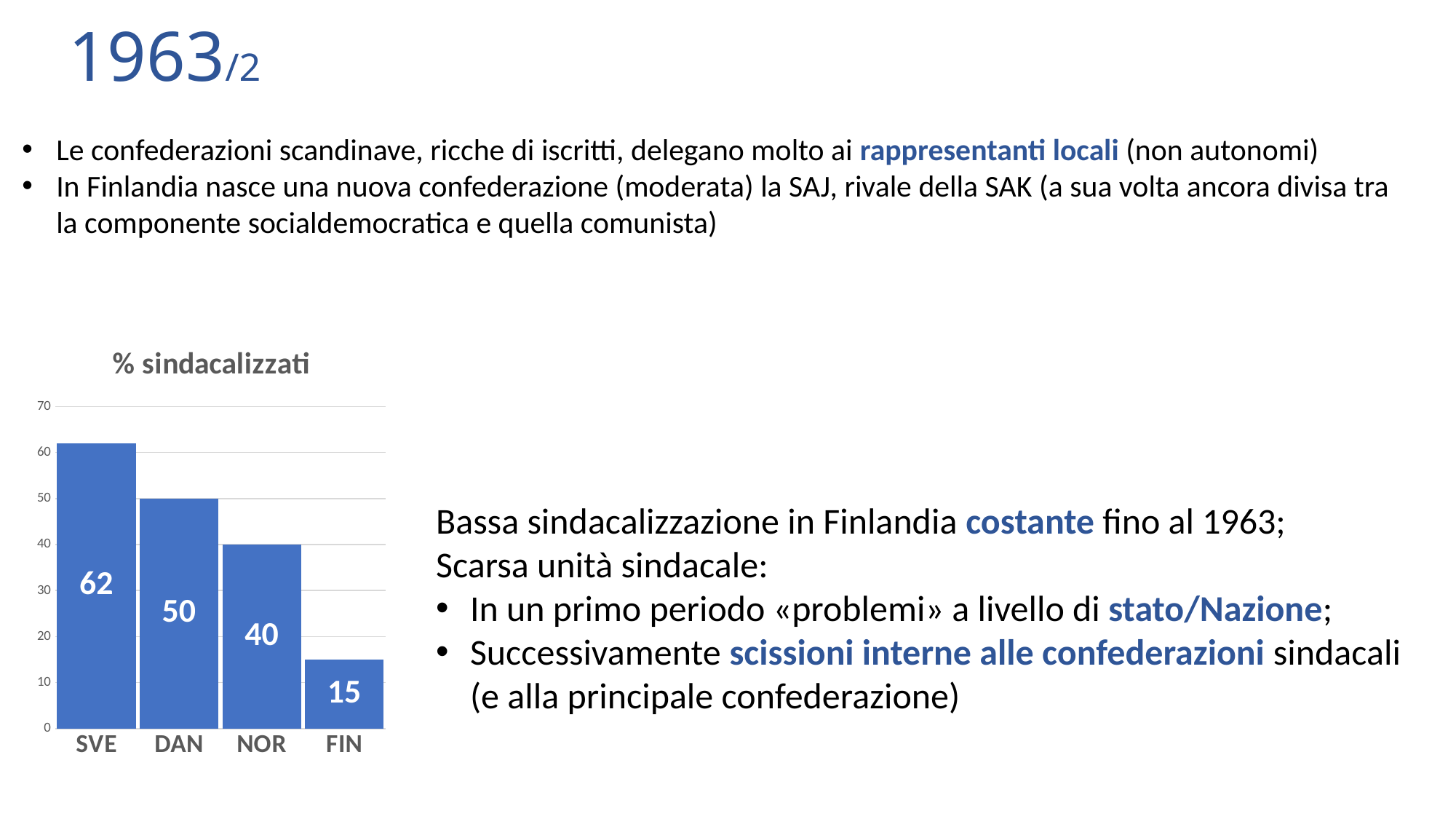
What is the value for SVE in the '% sindacalizzati' chart? 62 What is the difference between the values for SVE and FIN in the '% sindacalizzati' chart? 47 What is the value for FIN in the '% sindacalizzati' chart? 15 What is the difference between the values for DAN and NOR in the '% sindacalizzati' chart? 10 What kind of chart is the '% sindacalizzati' chart? bar chart Do the values in the '% sindacalizzati' chart rise or fall from left to right along the x axis? fall Which category has the highest value in the '% sindacalizzati' chart? SVE Which is larger in the '% sindacalizzati' chart, the value for DAN or the value for NOR? DAN Which category has the lowest value in the '% sindacalizzati' chart? FIN How many categories are shown in the '% sindacalizzati' chart? 4 What is the value for DAN in the '% sindacalizzati' chart? 50 What is the value for NOR in the '% sindacalizzati' chart? 40